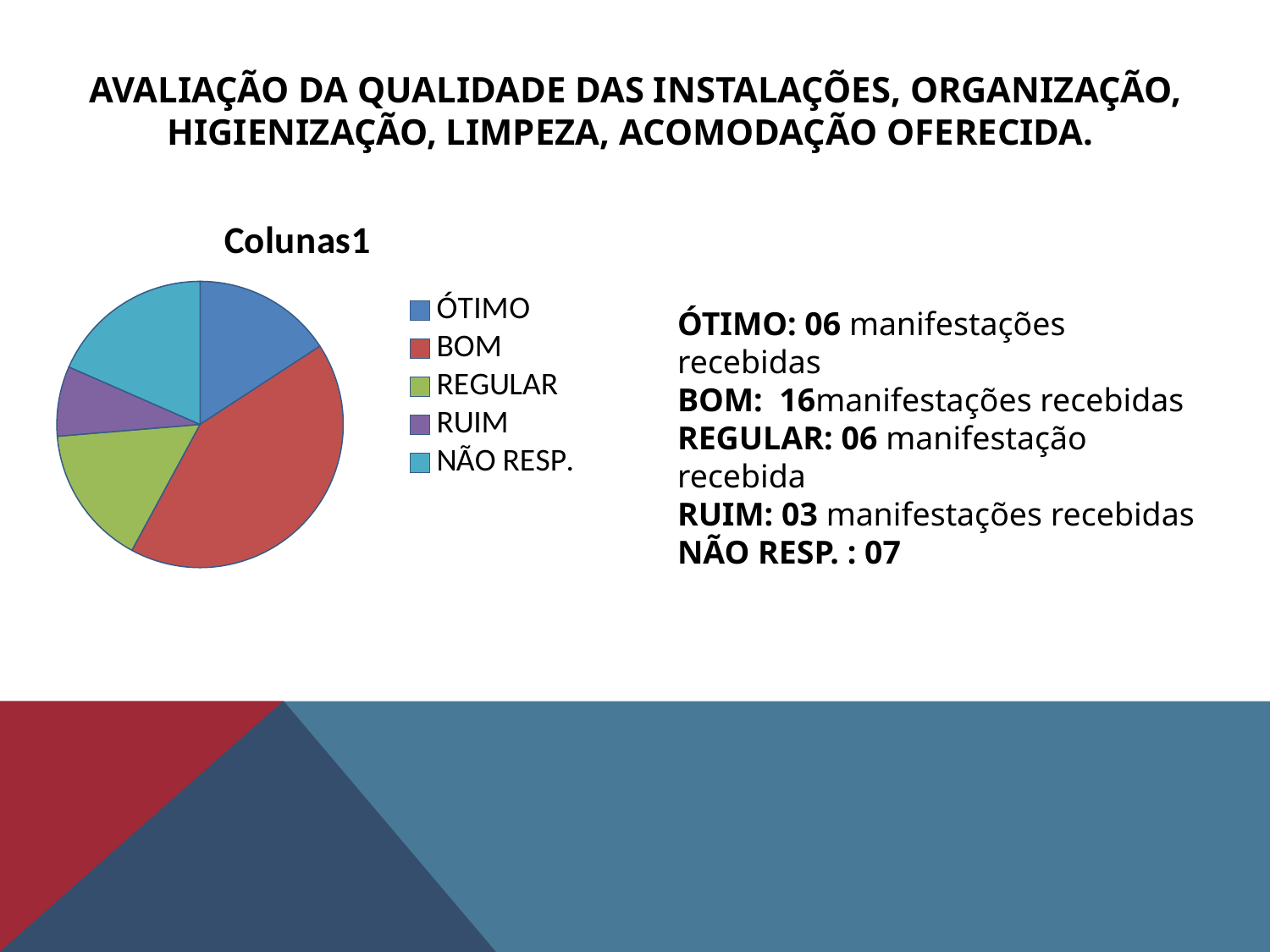
What is the difference between the number of manifestações for BOM and for RUIM? 13 What kind of chart is shown on the slide? pie chart How many manifestações recebidas are reported for RUIM? 03 Which slice is larger in the pie chart, RUIM or REGULAR? REGULAR Which category has the smallest slice of the pie chart? RUIM How many responses are reported for NÃO RESP.? 07 What is the title shown above the pie chart? Colunas1 Which slice is larger in the pie chart, BOM or NÃO RESP.? BOM What colour is the BOM slice in the pie chart? red How many manifestações recebidas are reported for BOM? 16 How many slices does the pie chart have? 5 Which category has the largest slice of the pie chart? BOM